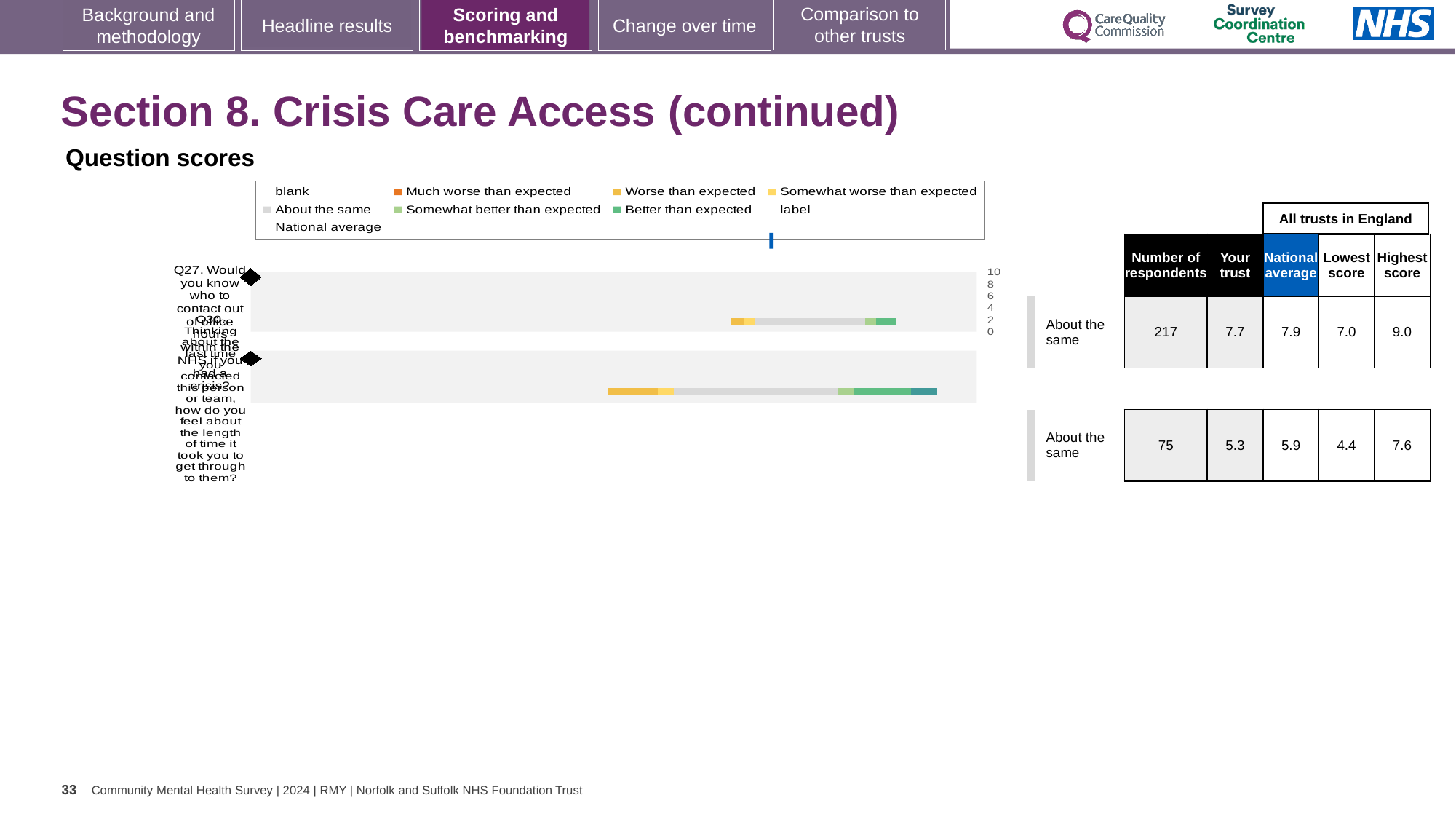
For Q27, which is larger: the 'Your trust' score or the national average? National average How many survey questions are plotted in the question scores chart? 2 What is the difference between the highest and lowest scores for the second question (about the length of time it took to get through)? 3.2 What benchmark category is shown for Q27? About the same What colour does the legend use for 'Much worse than expected'? orange What is the 'Your trust' score for Q27 (Would you know who to contact out of office hours within the NHS if you had a crisis?)? 7.7 How many respondents answered Q27? 217 What is the 'Your trust' score for the second question (about the length of time it took to get through to the person or team)? 5.3 What kind of chart is used to show the question scores on this slide? bar chart What is the national average score for the second question (about the length of time it took to get through)? 5.9 What is the highest score among all trusts in England for Q27? 9.0 What is the national average score for Q27? 7.9